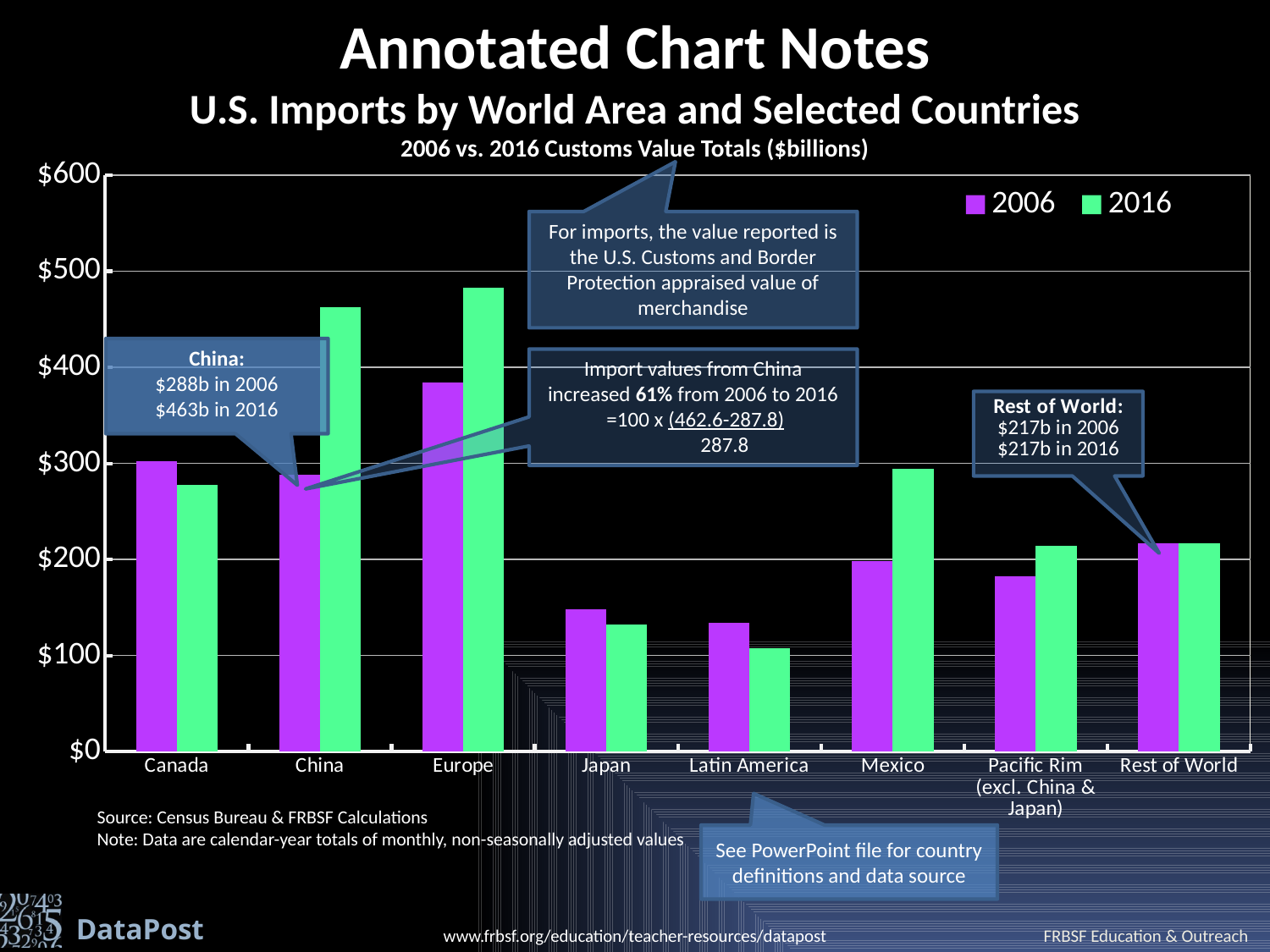
For Canada, which year has the larger bar, 2006 or 2016? 2006 Is the 2016 value for Mexico greater or less than $200? greater What was the value of U.S. imports from China in 2016, as stated in the annotation? $463b By what percentage did import values from China increase from 2006 to 2016, according to the annotation? 61% Which category has the tallest 2006 bar? Europe How many series does the legend list? 2 Is the 2016 value for Canada greater or less than $300? less What was the value of U.S. imports from Rest of World in 2016, as stated in the annotation? $217b How many categories are shown on the x axis? 8 What was the value of U.S. imports from China in 2006, as stated in the annotation? $288b Which category has the shortest 2016 bar? Latin America What kind of chart is shown on the slide? Bar chart